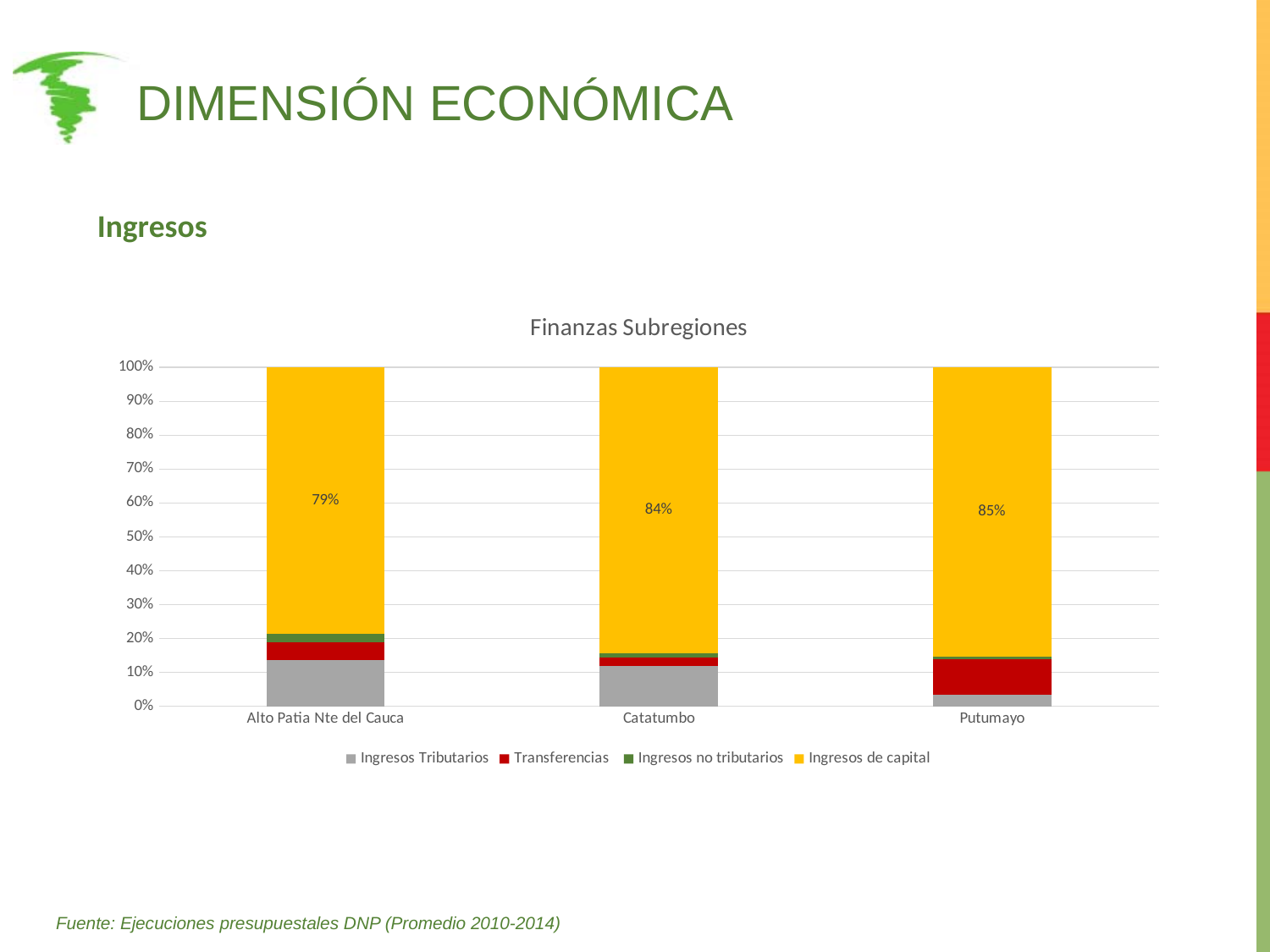
How many subregions are shown on the x axis of the chart? 3 Is the share of Ingresos Tributarios for Putumayo greater or less than 10%? less What is the value of Ingresos de capital for Alto Patia Nte del Cauca? 79% Which subregion has the lowest share of Ingresos de capital? Alto Patia Nte del Cauca What is the difference in Ingresos de capital between Putumayo and Alto Patia Nte del Cauca? 6 percentage points Which has a larger share of Ingresos de capital, Alto Patia Nte del Cauca or Catatumbo? Catatumbo Which subregion has the highest share of Ingresos de capital? Putumayo What type of chart is shown on the slide? Stacked bar chart Is the share of Ingresos Tributarios for Alto Patia Nte del Cauca greater or less than 10%? greater How many series does the chart legend list? 4 What is the value of Ingresos de capital for Putumayo? 85% What is the value of Ingresos de capital for Catatumbo? 84%